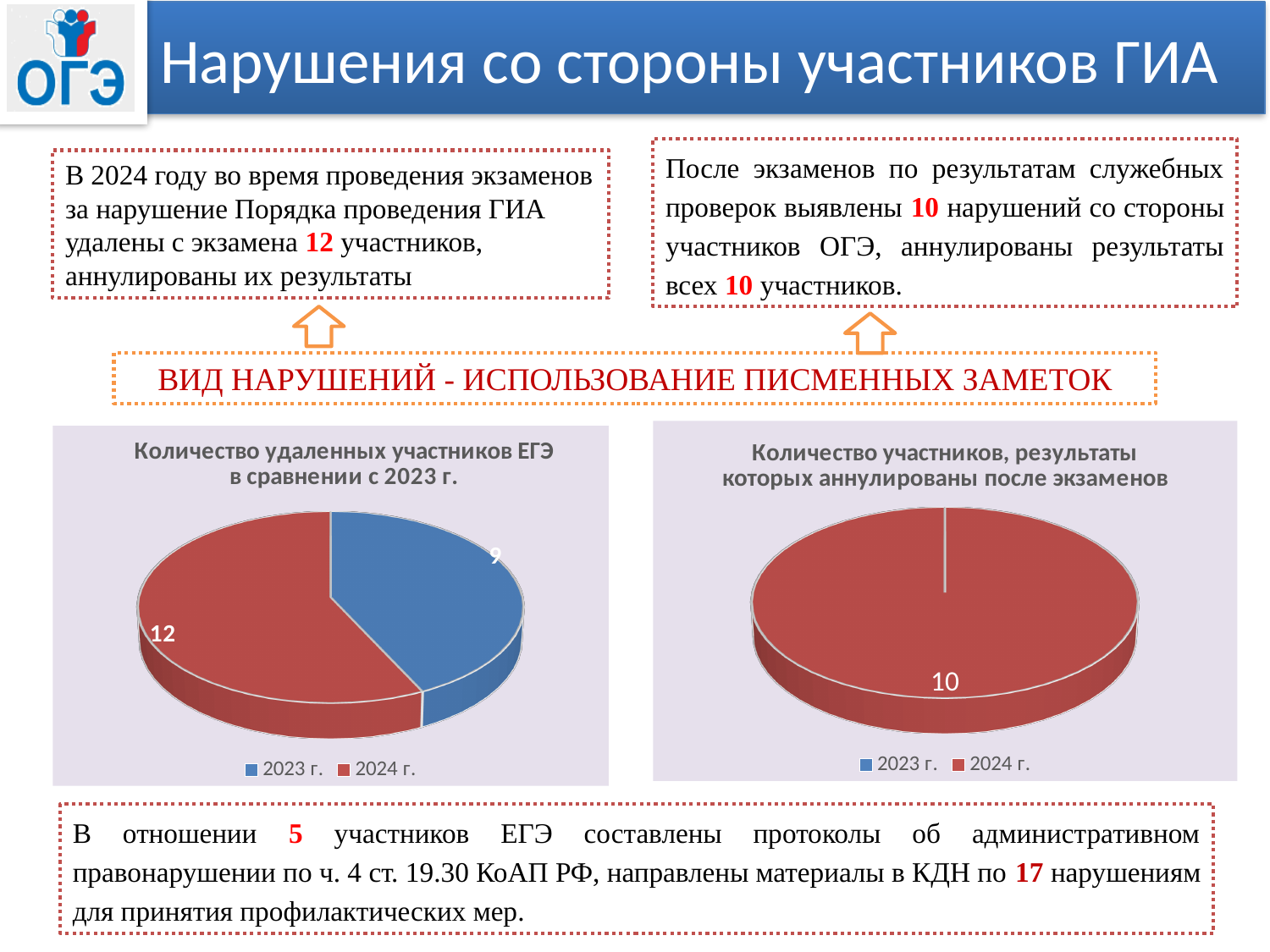
What type of chart is the left chart 'Количество удаленных участников ЕГЭ в сравнении с 2023 г.'? pie chart In the left chart 'Количество удаленных участников ЕГЭ в сравнении с 2023 г.', what colour is the slice for 2023 г.? blue In the left chart 'Количество удаленных участников ЕГЭ в сравнении с 2023 г.', what is the value for 2023 г.? 9 In the right chart 'Количество участников, результаты которых аннулированы после экзаменов', which year does the red slice represent? 2024 г. In the left chart 'Количество удаленных участников ЕГЭ в сравнении с 2023 г.', which year has the smaller slice? 2023 г. In the left chart 'Количество удаленных участников ЕГЭ в сравнении с 2023 г.', what is the difference between the 2024 г. and 2023 г. values? 3 In the left chart 'Количество удаленных участников ЕГЭ в сравнении с 2023 г.', what is the total of the two slices? 21 In the left chart 'Количество удаленных участников ЕГЭ в сравнении с 2023 г.', which year has the larger slice? 2024 г. In the left chart 'Количество удаленных участников ЕГЭ в сравнении с 2023 г.', what is the value for 2024 г.? 12 In the left chart 'Количество удаленных участников ЕГЭ в сравнении с 2023 г.', is the value for 2023 г. larger or smaller than the value for 2024 г.? smaller In the right chart 'Количество участников, результаты которых аннулированы после экзаменов', what value is printed on the pie? 10 How many entries does the legend of the right chart 'Количество участников, результаты которых аннулированы после экзаменов' list? 2